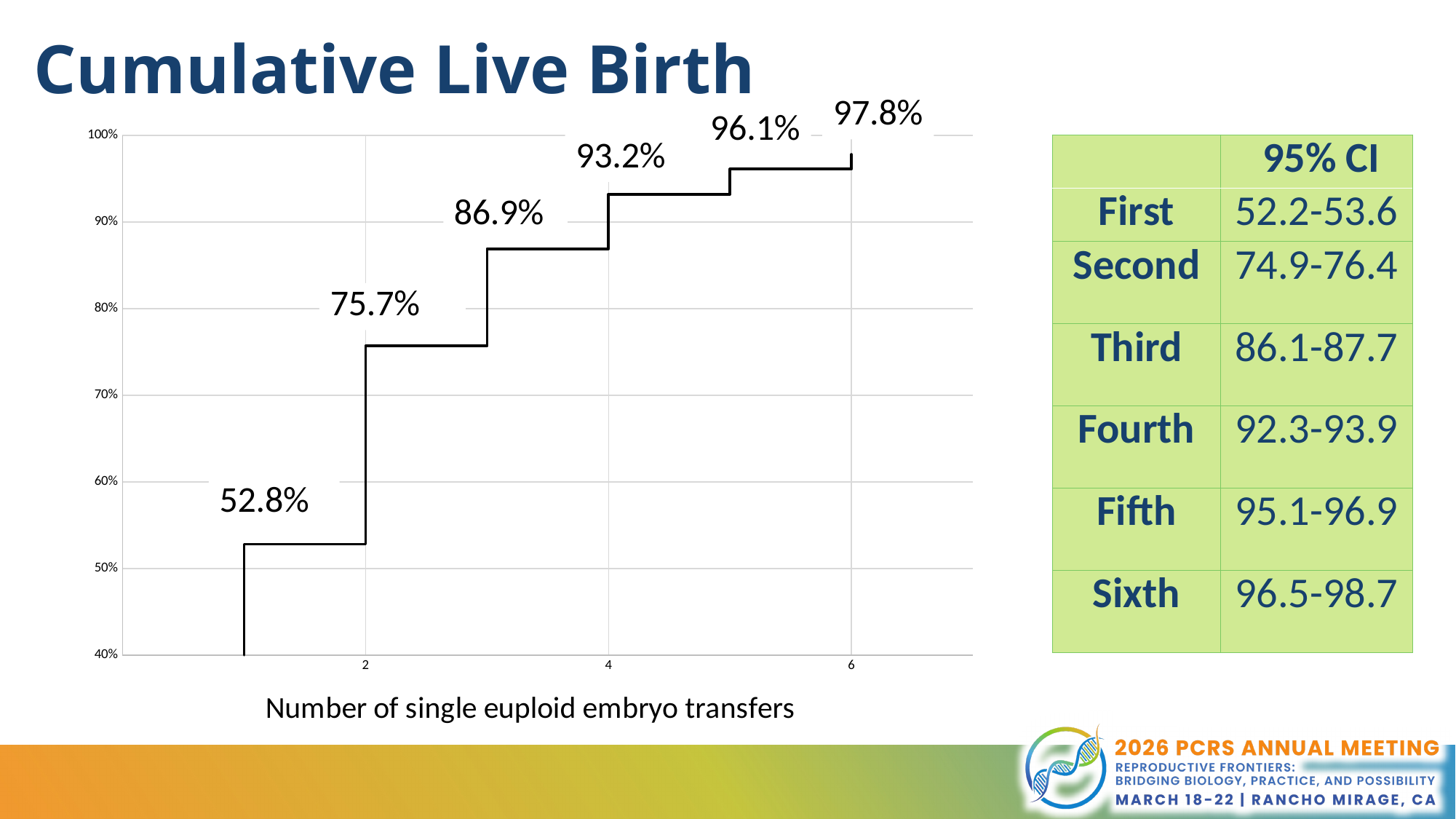
By how many percentage points does the cumulative live birth rate increase from the first to the second transfer? 22.9 What is the lowest cumulative live birth rate labelled on the chart? 52.8% What is the cumulative live birth rate after 3 single euploid embryo transfers? 86.9% Does the cumulative live birth rate rise or fall as the number of single euploid embryo transfers increases? rise What is the cumulative live birth rate after 2 single euploid embryo transfers? 75.7% What is the highest cumulative live birth rate labelled on the chart? 97.8% What is the cumulative live birth rate after the first single euploid embryo transfer? 52.8% How many data points are labelled on the chart? 6 What is the label on the x axis of the chart? Number of single euploid embryo transfers By how many percentage points does the cumulative live birth rate increase from the fifth to the sixth transfer? 1.7 What is the cumulative live birth rate after 4 single euploid embryo transfers? 93.2% What is the cumulative live birth rate after 6 single euploid embryo transfers? 97.8%